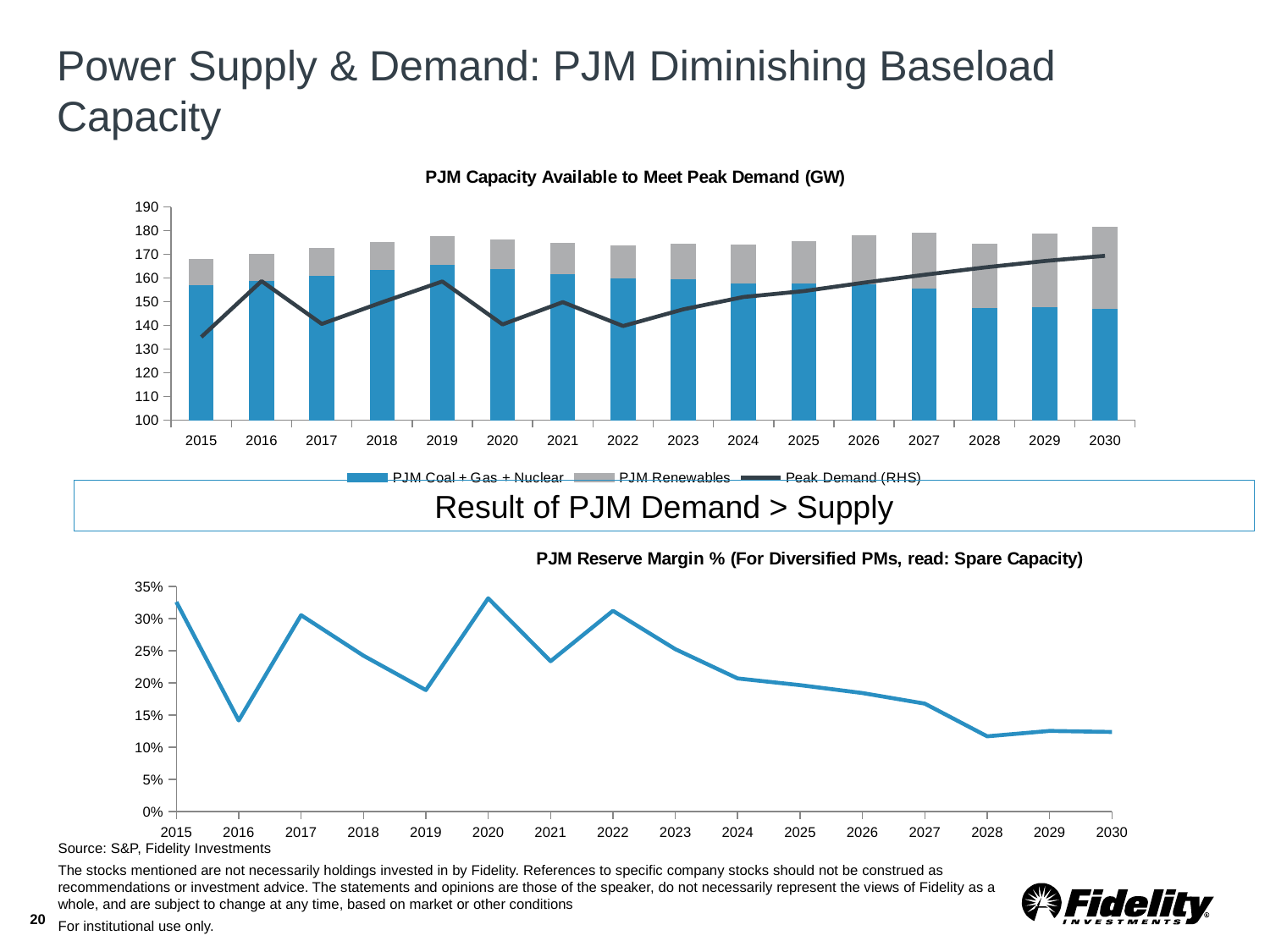
In the bottom chart, is the value for 2016 greater or less than 15%? less In the top chart, is the Peak Demand (RHS) value for 2015 greater or less than 140? less What kind of chart is the top chart, 'PJM Capacity Available to Meet Peak Demand (GW)'? Stacked bar chart with a line In the top chart, how many series does the legend list? 3 In the bottom chart, does the reserve margin rise or fall from 2022 to 2030? Falls In the top chart, which is larger, the PJM Coal + Gas + Nuclear value for 2019 or for 2028? 2019 In the bottom chart, which year has the lowest reserve margin? 2028 In the top chart, is the PJM Coal + Gas + Nuclear value for 2028 greater or less than 150? less What kind of chart is the bottom chart, 'PJM Reserve Margin %'? Line chart In the top chart, does the Peak Demand (RHS) line rise or fall from 2022 to 2030? Rises In the top chart, how many years are shown on the x axis? 16